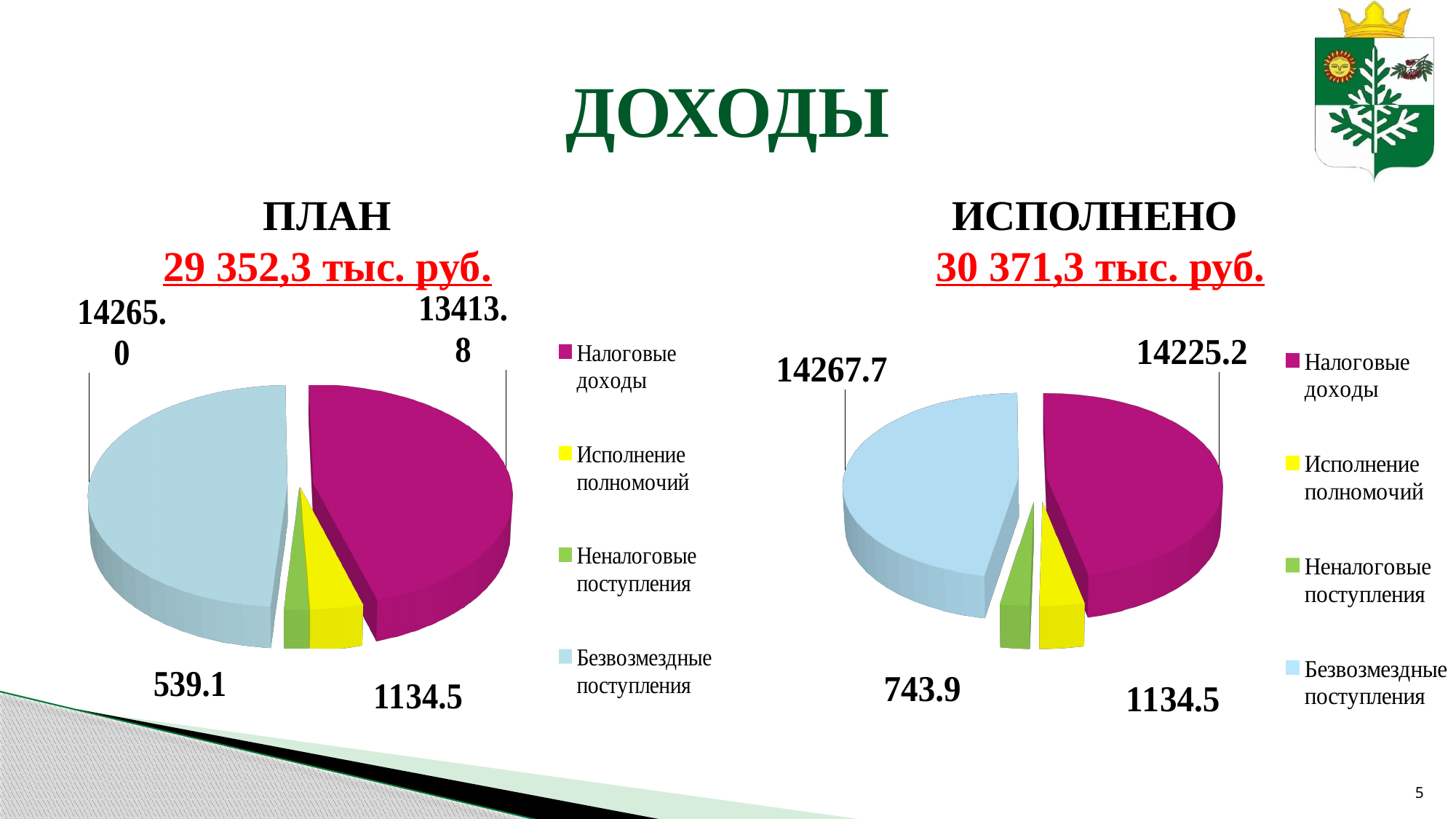
In the ПЛАН chart, what is the difference between Безвозмездные поступления and Налоговые доходы? 851.2 In the ИСПОЛНЕНО chart, which category has the smallest value? Неналоговые поступления In the ИСПОЛНЕНО chart, what is the difference between Безвозмездные поступления and Налоговые доходы? 42.5 In the ПЛАН chart, what is the value for Исполнение полномочий? 1134.5 In the ИСПОЛНЕНО chart, what is the value for Безвозмездные поступления? 14267.7 In the ПЛАН chart, which category has the largest value? Безвозмездные поступления In the ИСПОЛНЕНО chart, what is the value for Неналоговые поступления? 743.9 How many categories does the ПЛАН pie chart show? 4 What total is shown under the ИСПОЛНЕНО heading? 30 371,3 тыс. руб. Which is larger: Неналоговые поступления in the ПЛАН chart or in the ИСПОЛНЕНО chart? ИСПОЛНЕНО In the ПЛАН chart, what is the value for Налоговые доходы? 13413.8 What type of chart is used for ИСПОЛНЕНО? Pie chart